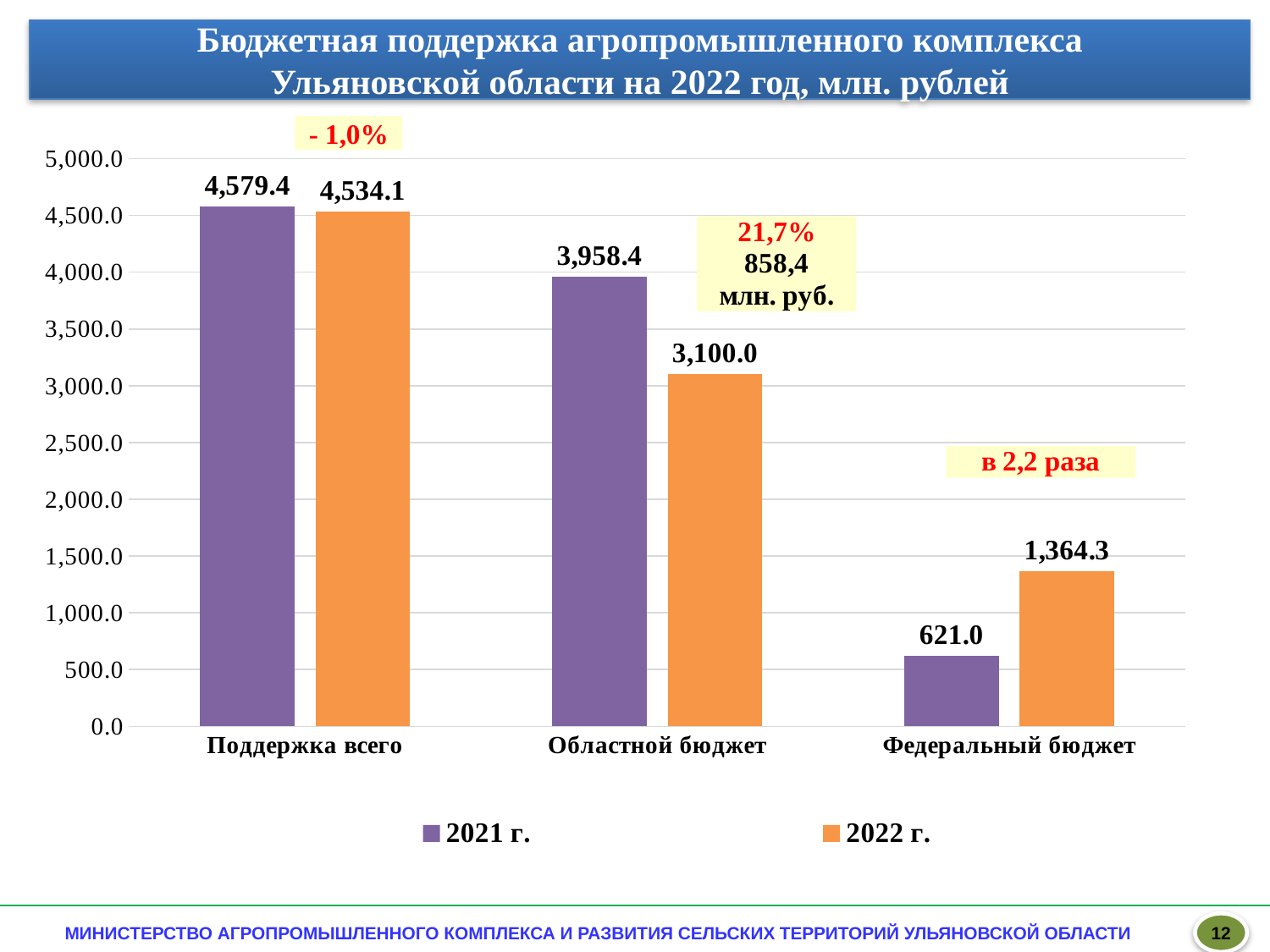
What is the value for 2021 г. in the category Федеральный бюджет? 621.0 Which category has the highest value for the 2022 г. series? Поддержка всего What type of chart is shown on the slide? bar chart How many categories are shown on the x axis? 3 Which series is shown in orange in the legend? 2022 г. Which category has the lowest value for the 2021 г. series? Федеральный бюджет What is the value for 2022 г. in the category Областной бюджет? 3,100.0 In the category Федеральный бюджет, which series has the larger value, 2021 г. or 2022 г.? 2022 г. What is the value for 2022 г. in the category Федеральный бюджет? 1,364.3 How many series does the legend list? 2 What is the value for 2021 г. in the category Поддержка всего? 4,579.4 What is the difference between the 2021 г. and 2022 г. values for Областной бюджет? 858.4